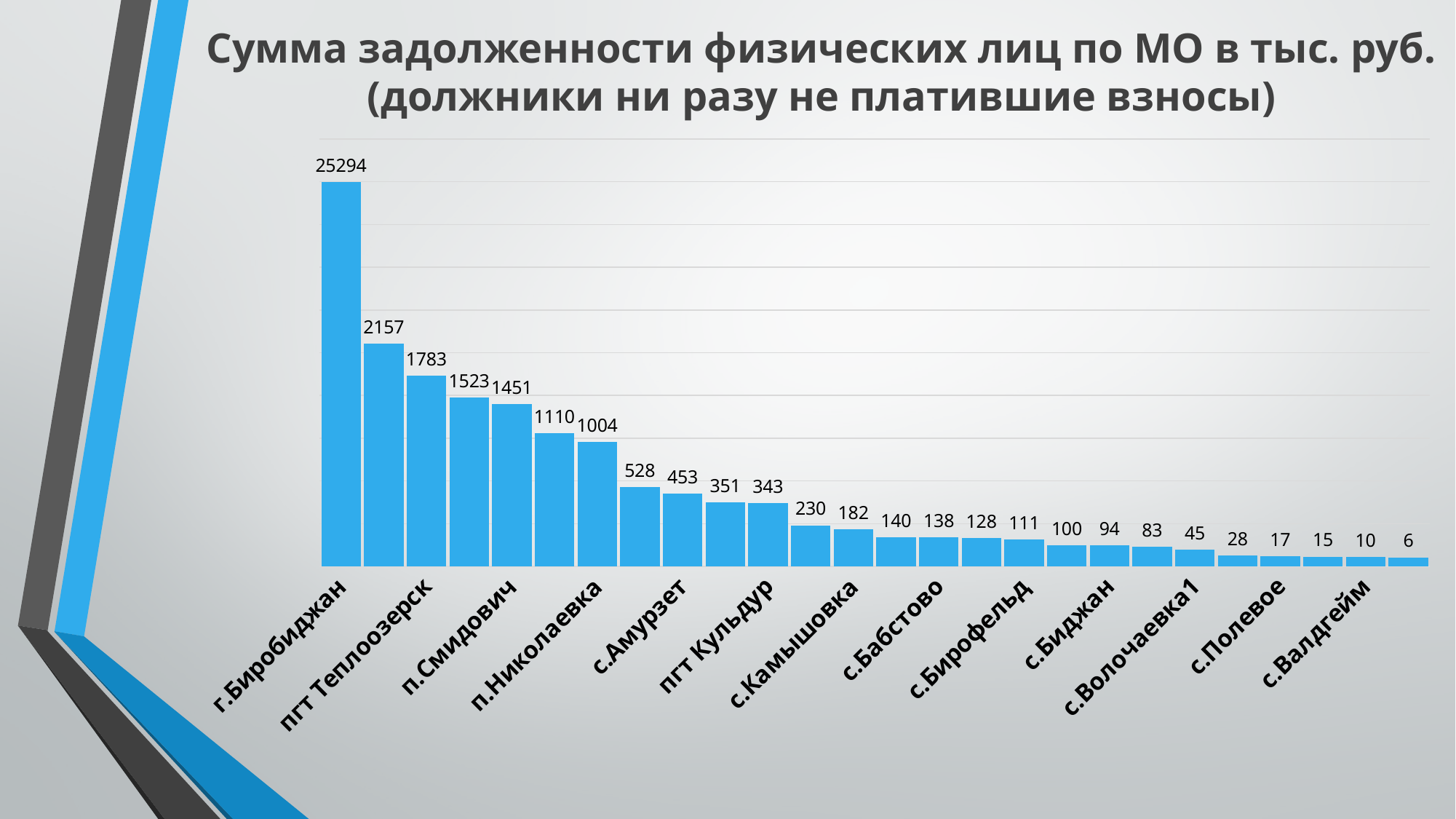
What is the value for п.Смидович? 1451 What is the smallest value shown on the chart? 6 What is the value for г.Биробиджан? 25294 What is the difference between the values for г.Биробиджан and пгт Теплоозерск? 23511 What is the value for пгт Теплоозерск? 1783 What is the value for с.Амурзет? 453 What is the value for с.Волочаевка1? 45 Do the values rise or fall from left to right along the x axis? fall How many bars are plotted on the chart? 26 Which is larger, the value for п.Смидович or the value for п.Николаевка? п.Смидович Which category has the highest value? г.Биробиджан What kind of chart is shown on the slide? bar chart